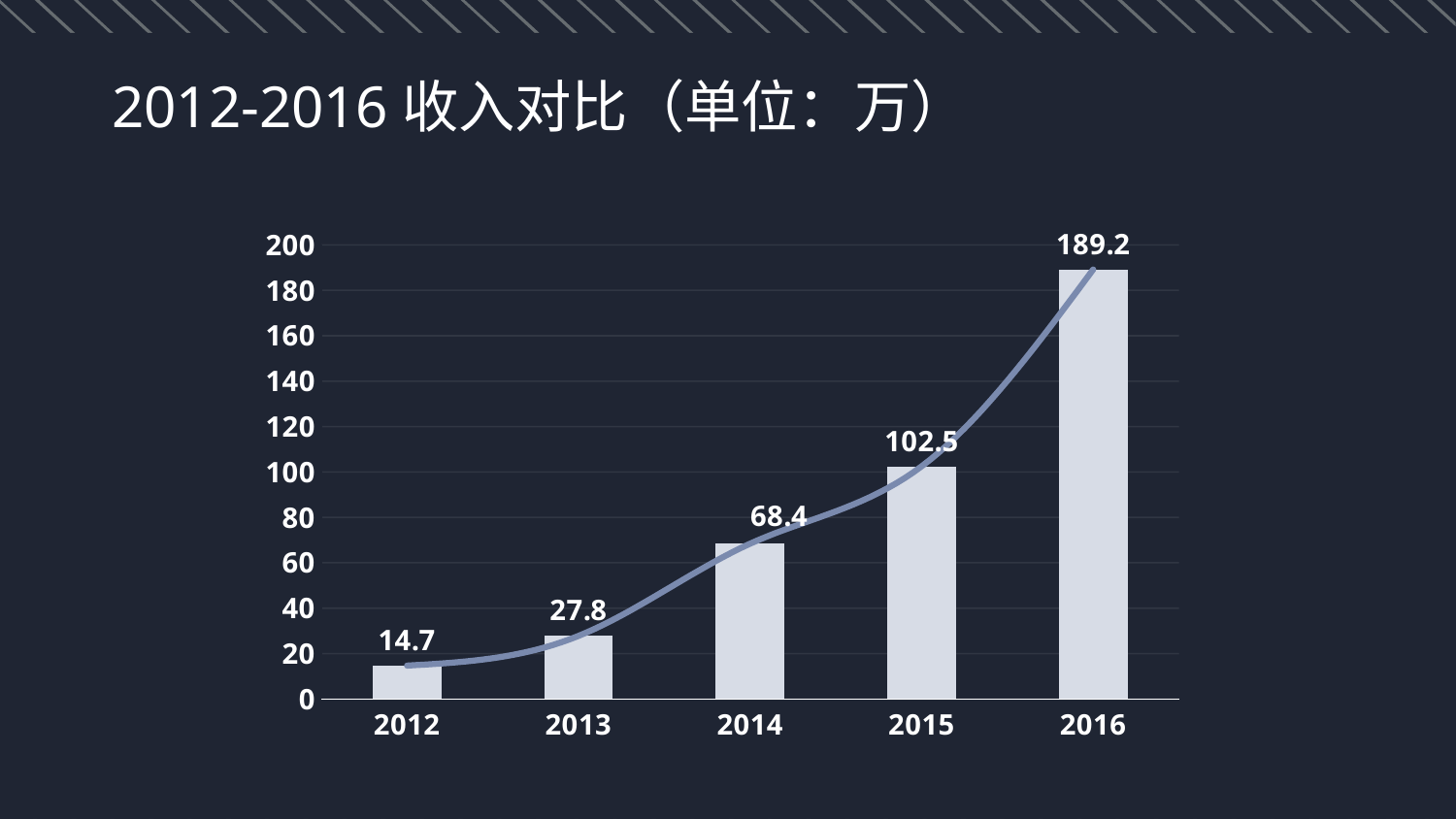
Which year has the lowest value? 2012 Do the values rise or fall from 2012 to 2016? rise What is the value for 2014? 68.4 What is the title of the chart slide? 2012-2016 收入对比（单位：万） What is the value for 2012? 14.7 What is the difference between the values for 2013 and 2012? 13.1 What is the difference between the values for 2016 and 2015? 86.7 Which is larger, the value for 2014 or the value for 2015? 2015 Is the value for 2015 greater or less than 100? greater Which year has the highest value? 2016 What is the value for 2016? 189.2 How many years are shown on the x axis? 5